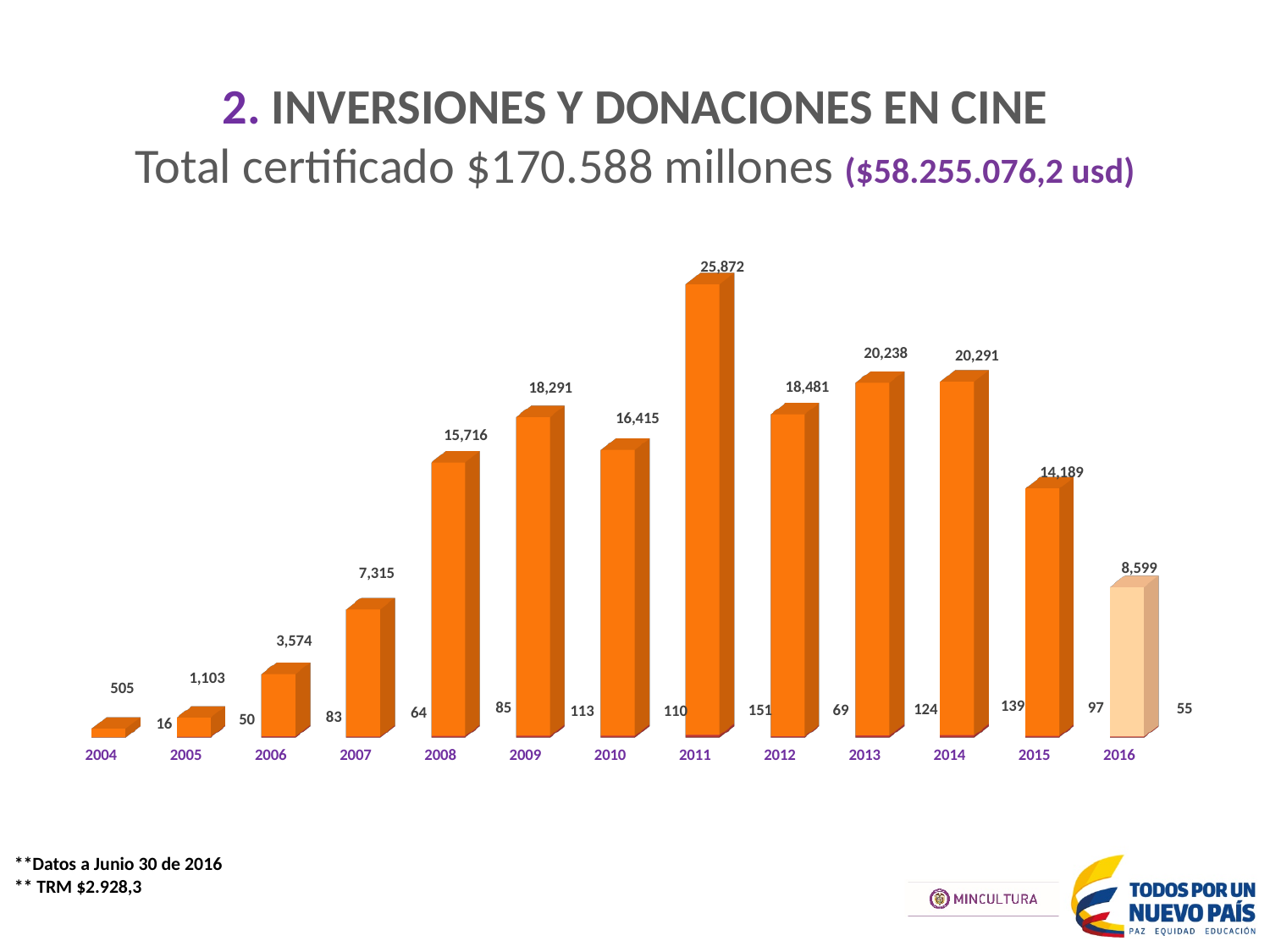
What kind of chart is shown on the slide? bar chart Do the bar values rise or fall from 2004 to 2011? rise What is the difference between the values for 2011 and 2015? 11,683 How many years are shown on the x axis? 13 What is the difference between the values for 2014 and 2013? 53 Which year has the lowest bar? 2004 What is the value shown for 2016? 8,599 What is the value shown for 2008? 15,716 Which year has the highest bar? 2011 What total certified amount in millions is stated in the slide title? $170.588 millones Which is larger, the value for 2009 or the value for 2010? 2009 What is the value shown for 2011? 25,872